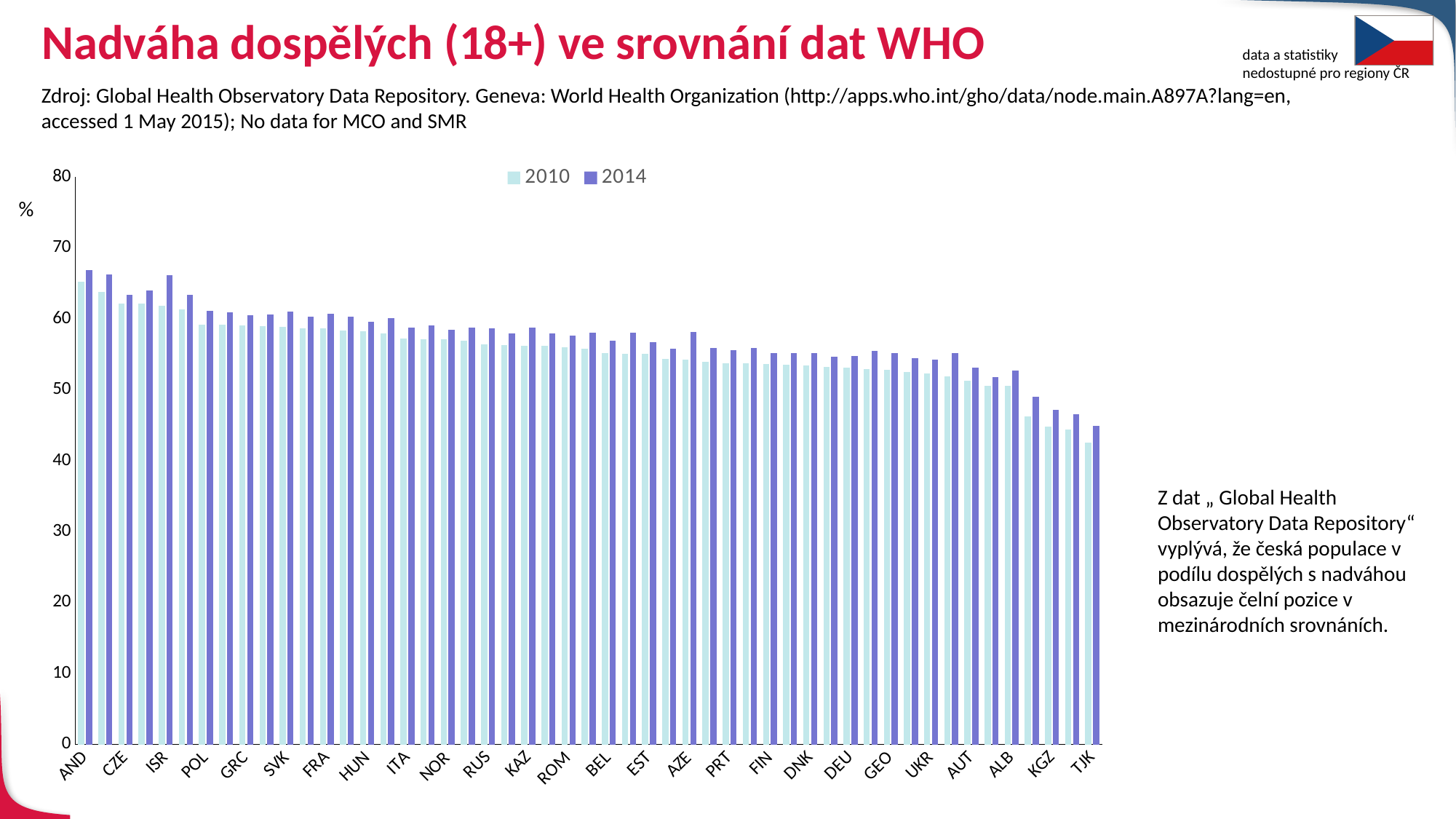
Which is larger, the 2014 value for ISR or the 2014 value for POL? ISR How many series does the legend list? 2 What kind of chart is shown on the slide? bar chart Is the 2010 value for TJK greater or less than 50? less What are the two series named in the legend? 2010 and 2014 Is the 2014 value for AUT greater or less than 50? greater Is the 2014 value for AND greater or less than 60? greater Which of the labelled countries has the lowest 2010 value? TJK What unit is shown on the vertical axis? % Do the values generally rise or fall moving from left to right along the x axis? fall